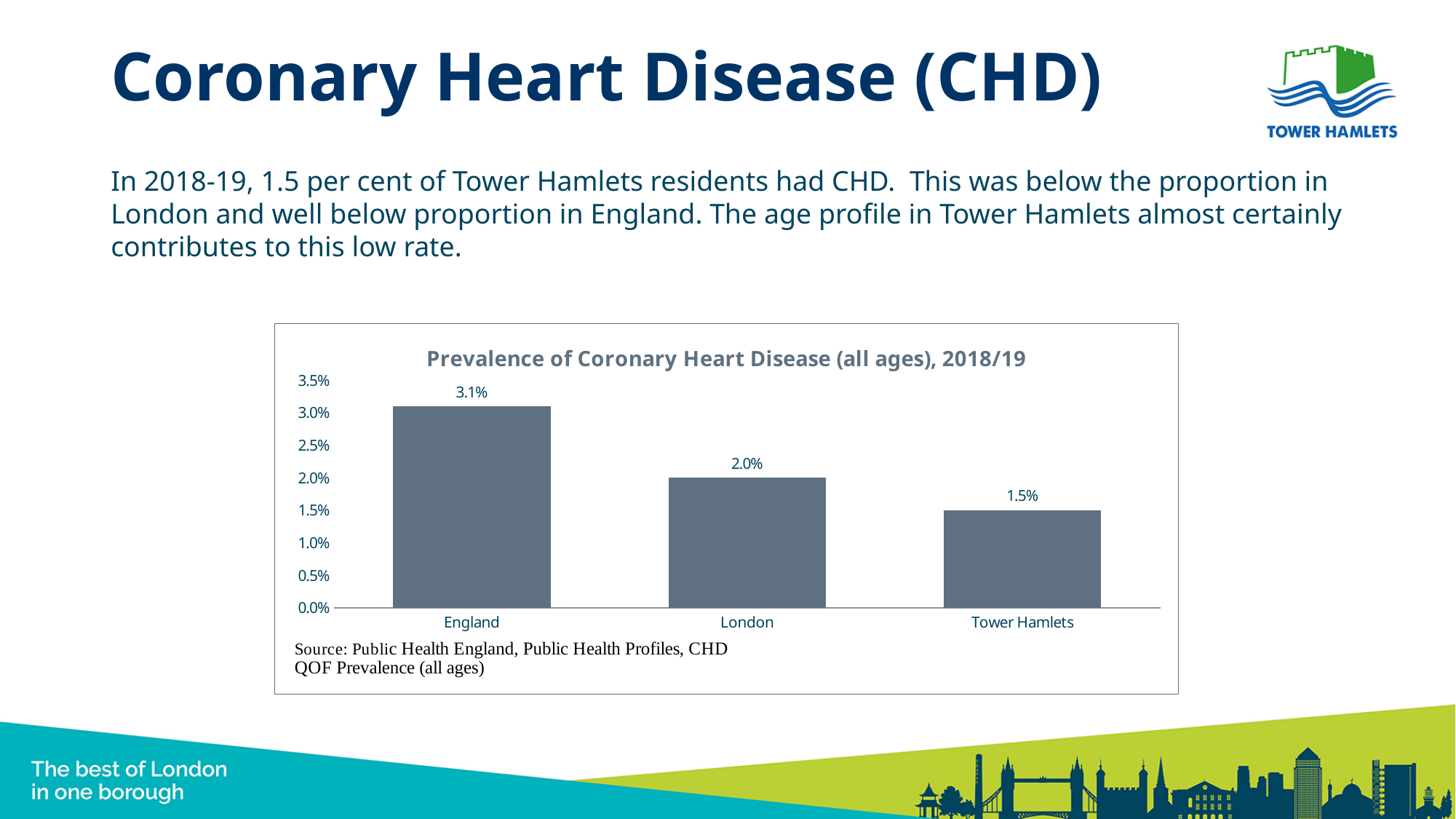
What is the difference in CHD prevalence between London and Tower Hamlets? 0.5% What is the CHD prevalence for London? 2.0% What is the difference in CHD prevalence between England and Tower Hamlets? 1.6% How many areas are shown in the chart? 3 Which area has the lowest CHD prevalence? Tower Hamlets What is the CHD prevalence for England? 3.1% What kind of chart is shown on the slide? Bar chart Is the value for England greater or less than 2.5%? greater What is the CHD prevalence for Tower Hamlets? 1.5% What is the title of the chart? Prevalence of Coronary Heart Disease (all ages), 2018/19 Which has a higher CHD prevalence, London or Tower Hamlets? London Which area has the highest CHD prevalence? England